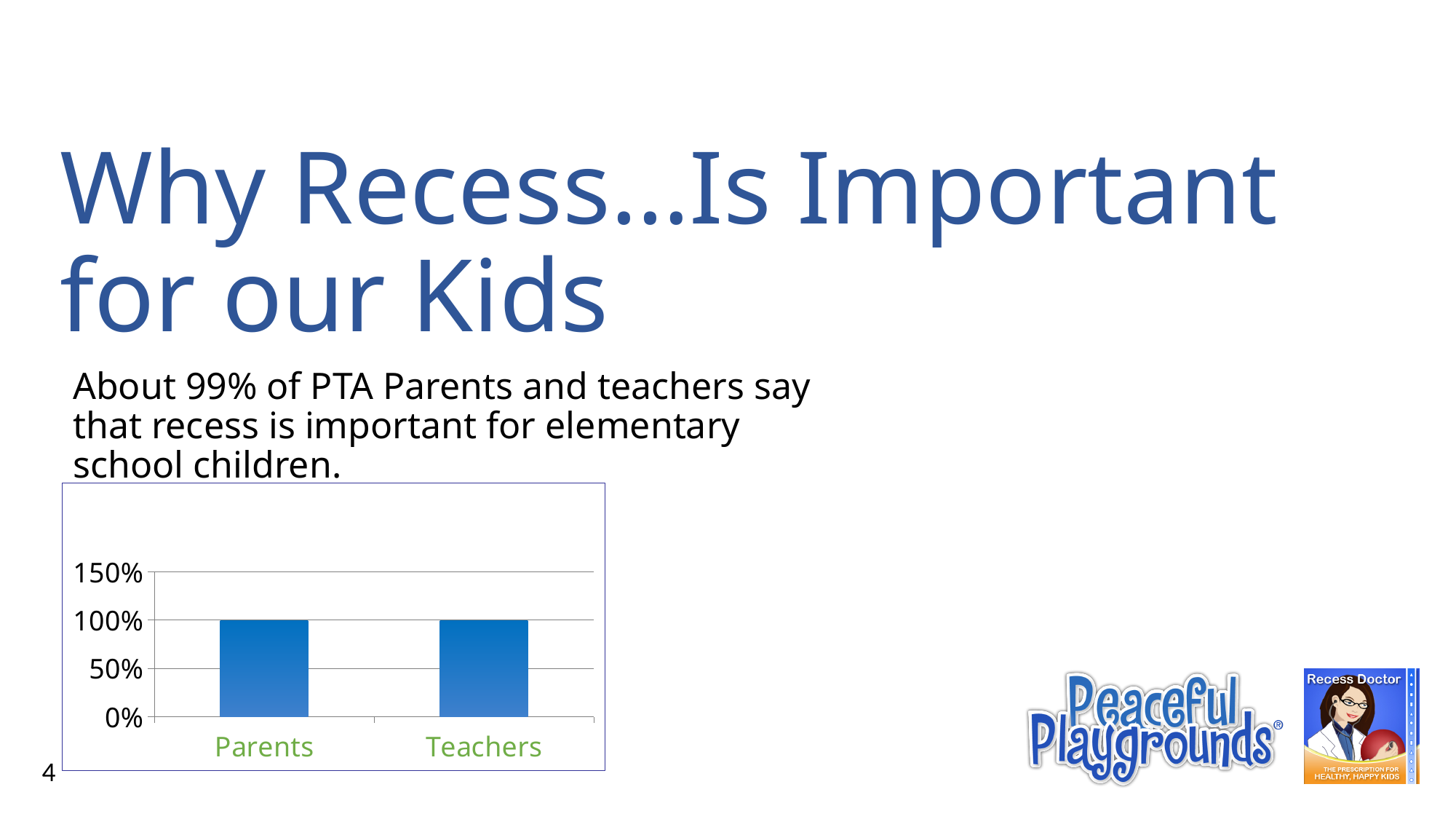
How many categories are shown on the x axis of the chart? 2 What kind of chart is shown on the slide? bar chart What is the highest tick value shown on the chart's vertical axis? 150% Is the value for Teachers greater or less than 150%? less Is the value for Parents greater or less than 50%? greater Is the value for Teachers greater or less than 50%? greater What are the two categories labelled on the x axis of the chart? Parents and Teachers